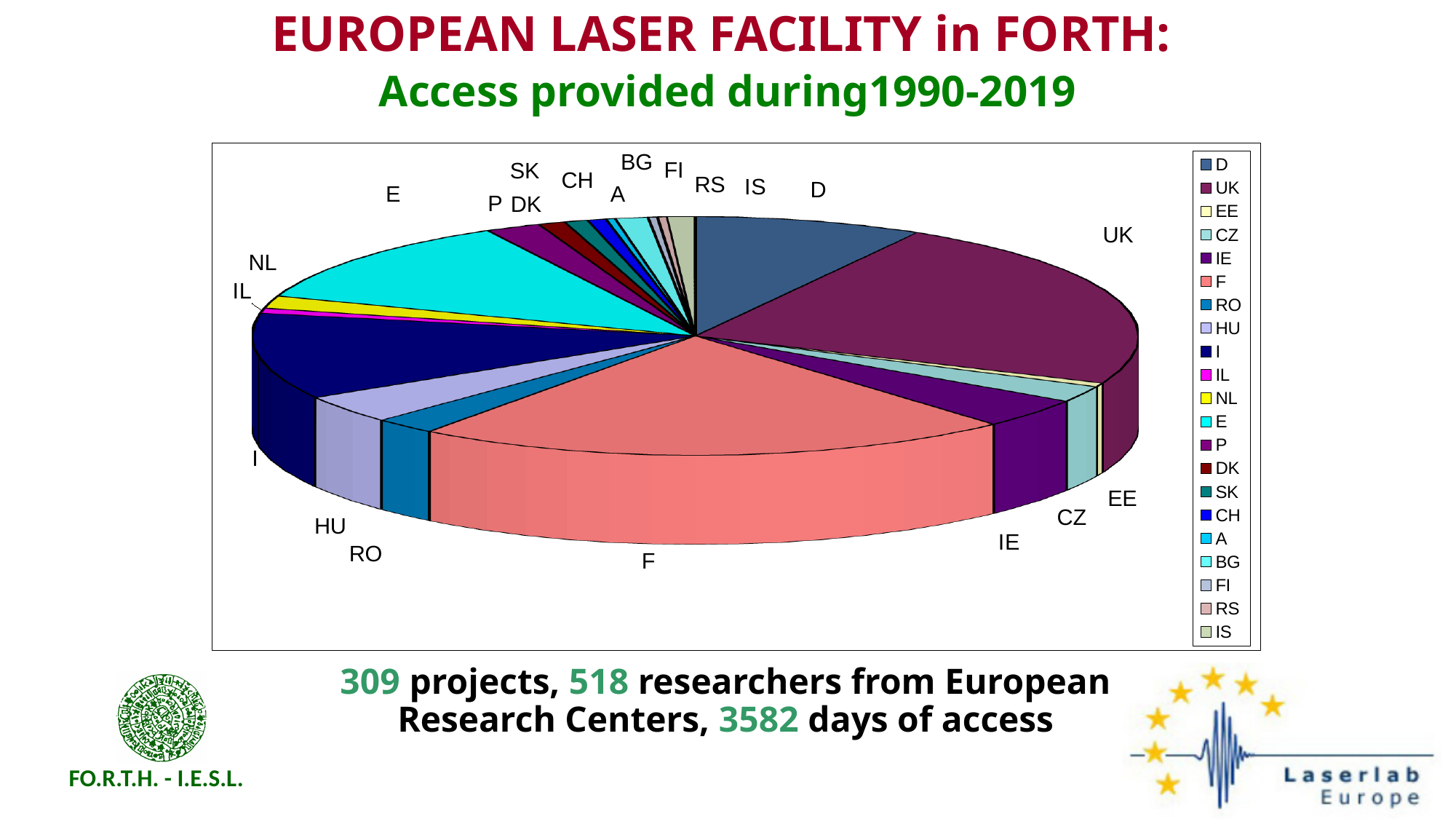
Which slice is larger in the pie chart, I or HU? I Which slice is larger in the pie chart, UK or D? UK What period does the slide subtitle say the access was provided during? 1990-2019 Which slice is larger in the pie chart, UK or E? UK How many countries (categories) does the pie chart show? 21 How many entries does the legend of the pie chart list? 21 What is the first entry listed in the legend of the pie chart? D What kind of chart is shown on the slide? Pie chart